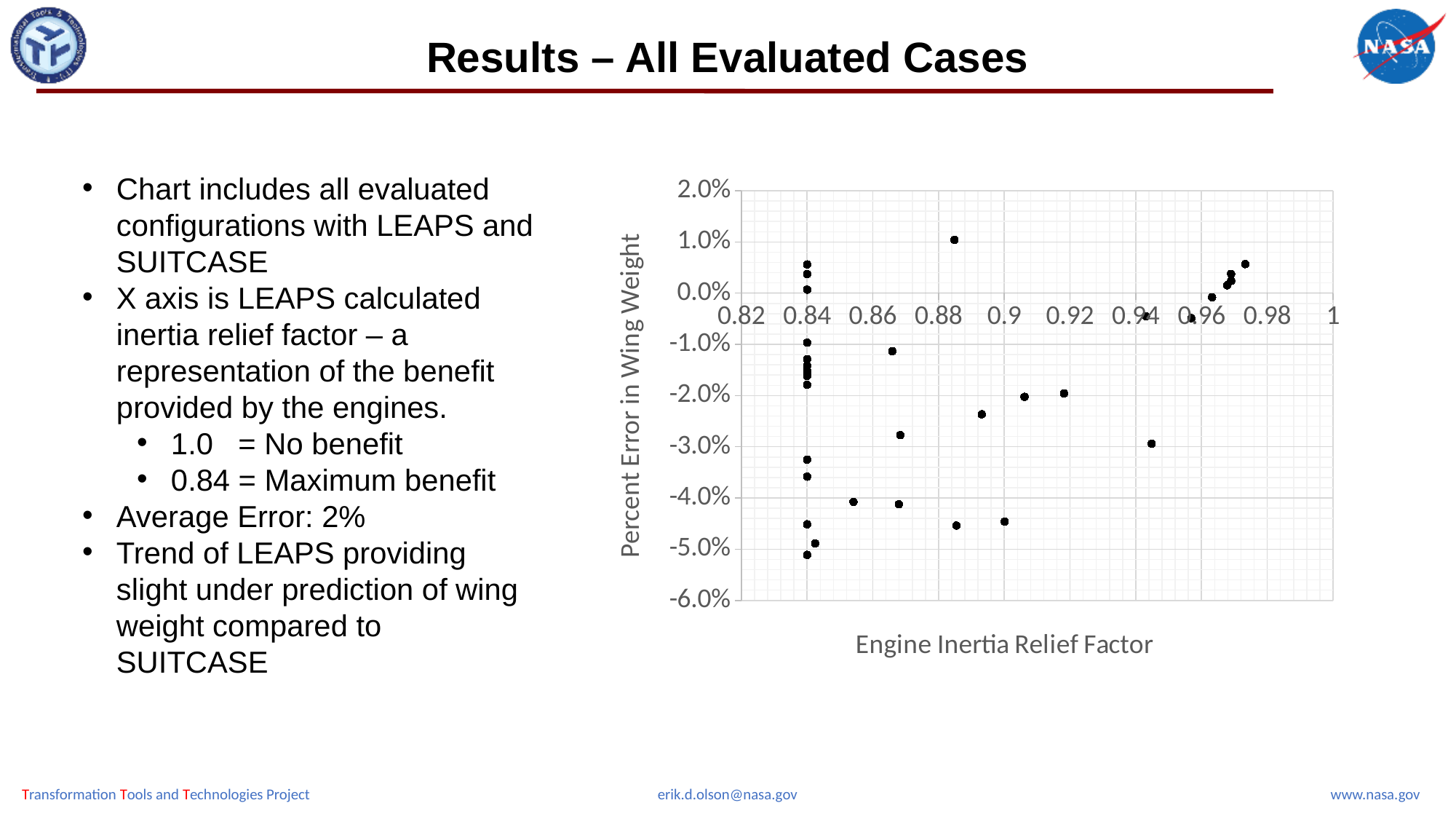
What is the title of the x axis of the chart? Engine Inertia Relief Factor What kind of chart is shown on the slide? scatter chart Is the percent error for the highest point on the chart, near an inertia relief factor of 0.885, greater or less than 0.0%? greater What is the highest value shown on the y axis of the chart? 2.0% What is the title of the y axis of the chart? Percent Error in Wing Weight What is the smallest tick value shown on the x axis of the chart? 0.82 Is the lowest point on the chart, at an inertia relief factor of 0.84, greater or less than -4.0%? less What is the lowest value shown on the y axis of the chart? -6.0% What is the largest tick value shown on the x axis of the chart? 1